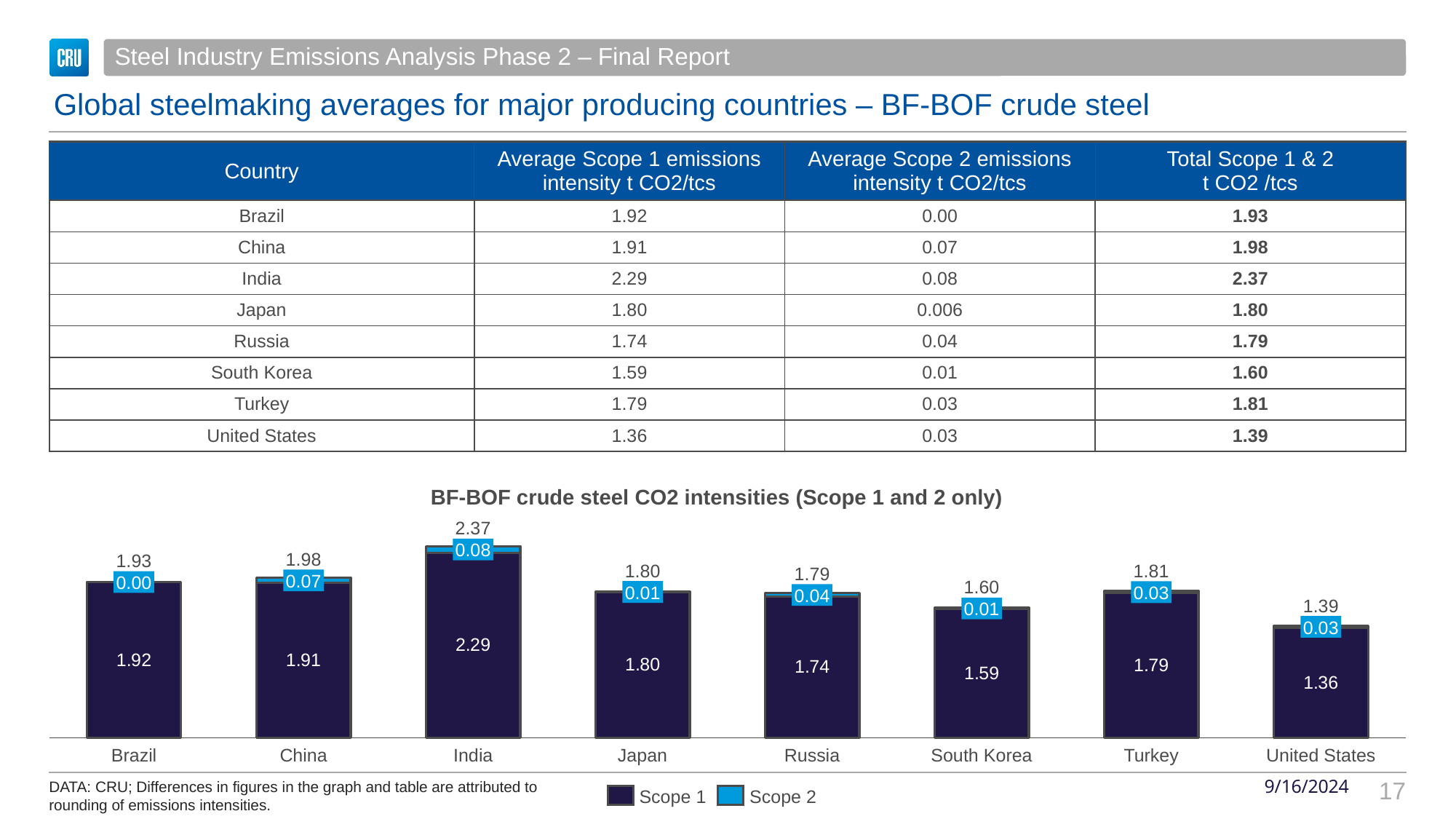
How many series does the chart's legend list? 2 What is the title of the chart? BF-BOF crude steel CO2 intensities (Scope 1 and 2 only) What kind of chart is shown on the slide? Stacked bar chart In the chart, what is the total (Scope 1 and 2) for India? 2.37 In the chart, what is the Scope 1 value for India? 2.29 In the chart, what is the Scope 1 value for the United States? 1.36 In the chart, which has the larger total CO2 intensity, Brazil or China? China Which country has the highest total CO2 intensity in the chart? India In the chart, what is the Scope 2 value for China? 0.07 In the chart, what is the difference between the total for India and the total for the United States? 0.98 Which country has the lowest total CO2 intensity in the chart? United States How many countries are shown on the x axis of the chart? 8